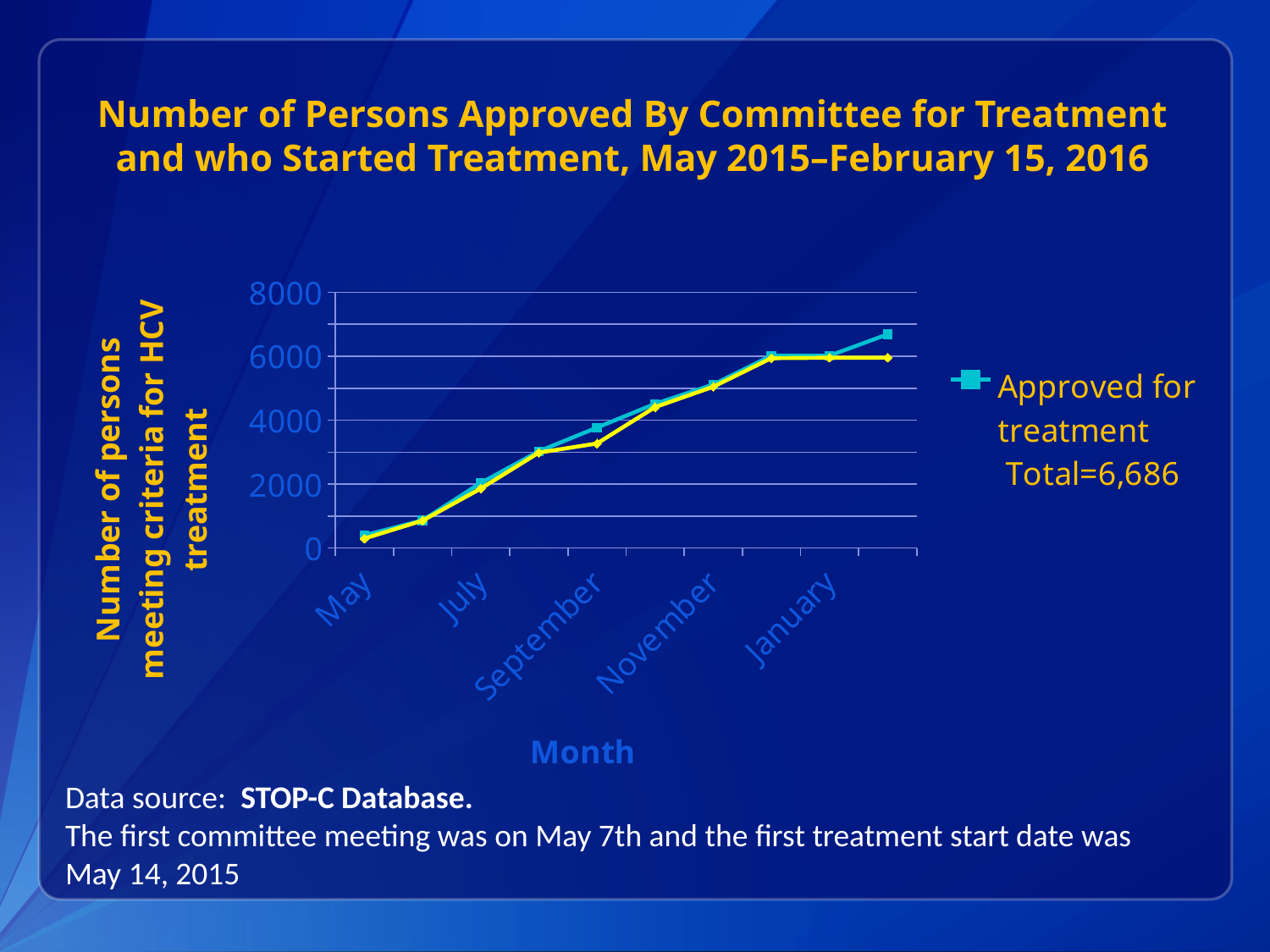
What total is given in the legend for Approved for treatment? Total=6,686 What is the title of the x axis? Month Is the value for Approved for treatment in July greater or less than 4000? less Is the value for Approved for treatment in January greater or less than 4000? greater How many lines are plotted on the chart? 2 In September, which line is higher: the Approved for treatment line or the yellow line? Approved for treatment Is the value for Approved for treatment in May greater or less than 2000? less How many month labels are printed on the x axis? 5 Do the values for Approved for treatment rise or fall from May to the end of the x axis? rise What kind of chart is shown on the slide? line chart